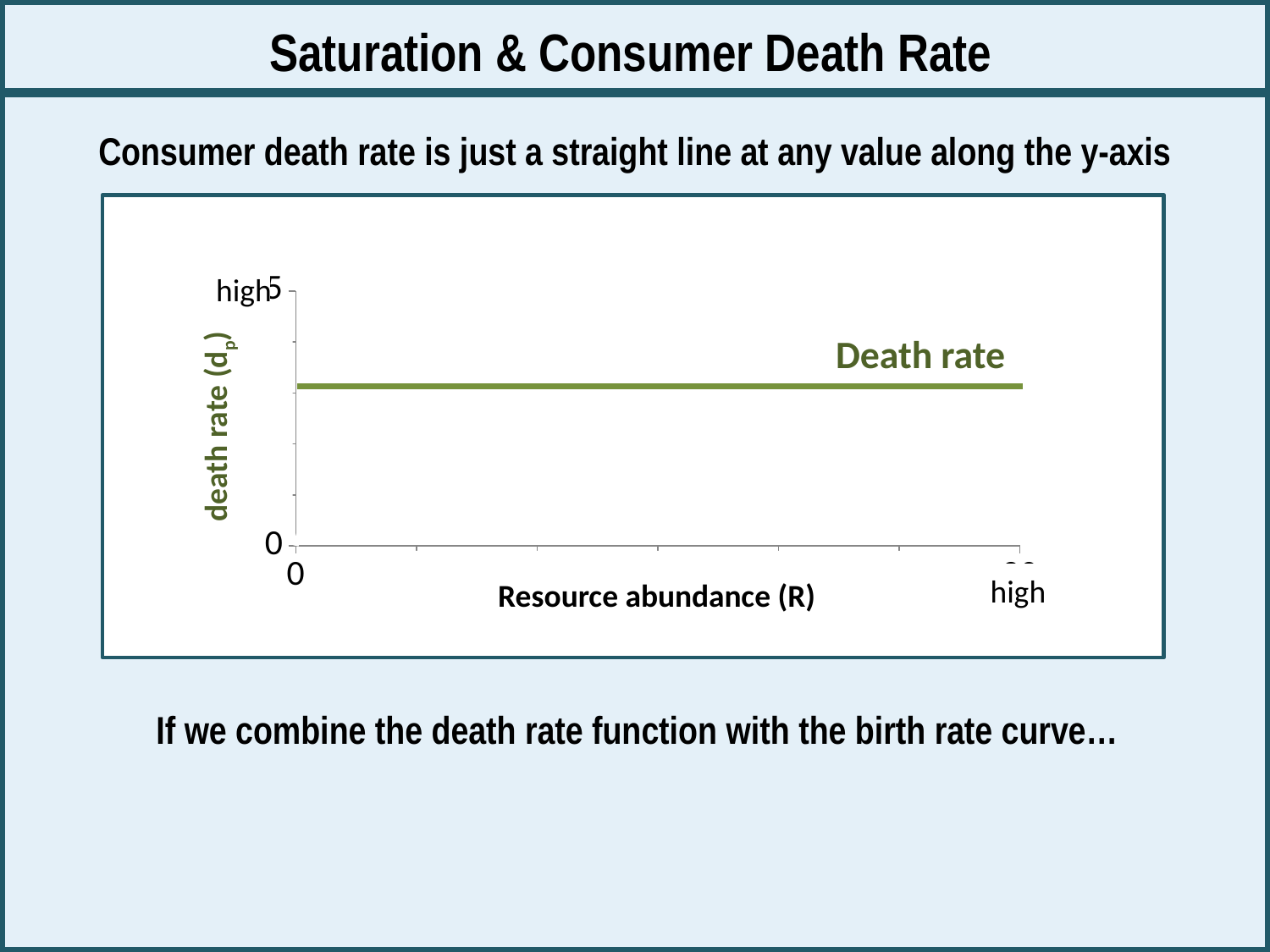
Does the death rate rise, fall, or remain flat across the x axis? remain flat What is the label of the plotted line in the chart? Death rate Is the death rate line greater or less than 5 on the y axis? less What kind of chart is shown on the slide? line chart Is the death rate line greater or less than 0 on the y axis? greater What is the highest value printed on the y axis of the chart? 5 What is the title of the x axis of the chart? Resource abundance (R) How does the death rate change as resource abundance (R) increases along the x axis? it stays constant What is the lowest value printed on the y axis of the chart? 0 How many data series are plotted in the chart? 1